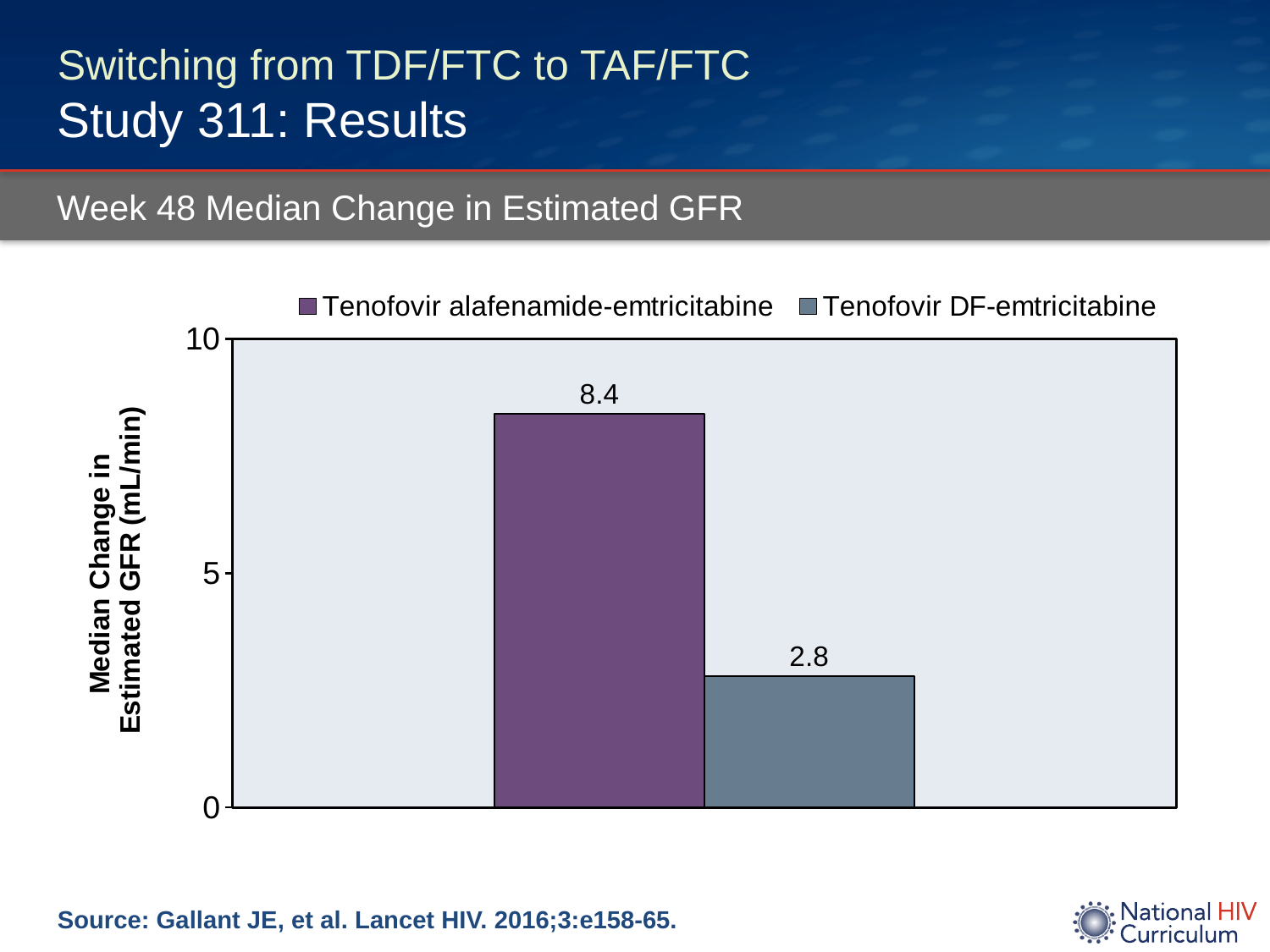
Is the median change in estimated GFR larger for Tenofovir alafenamide-emtricitabine or Tenofovir DF-emtricitabine? Tenofovir alafenamide-emtricitabine How many bars are plotted in the chart? 2 What is the median change in estimated GFR for Tenofovir DF-emtricitabine? 2.8 What is the difference in median change in estimated GFR between Tenofovir alafenamide-emtricitabine and Tenofovir DF-emtricitabine? 5.6 What is the label of the y-axis? Median Change in Estimated GFR (mL/min) Which series has the higher median change in estimated GFR? Tenofovir alafenamide-emtricitabine Which series has the lower median change in estimated GFR? Tenofovir DF-emtricitabine What is the median change in estimated GFR for Tenofovir alafenamide-emtricitabine? 8.4 Is the value for Tenofovir alafenamide-emtricitabine greater or less than 5? greater Is the value for Tenofovir DF-emtricitabine greater or less than 5? less What kind of chart is shown on the slide? Bar chart How many series does the legend list? 2